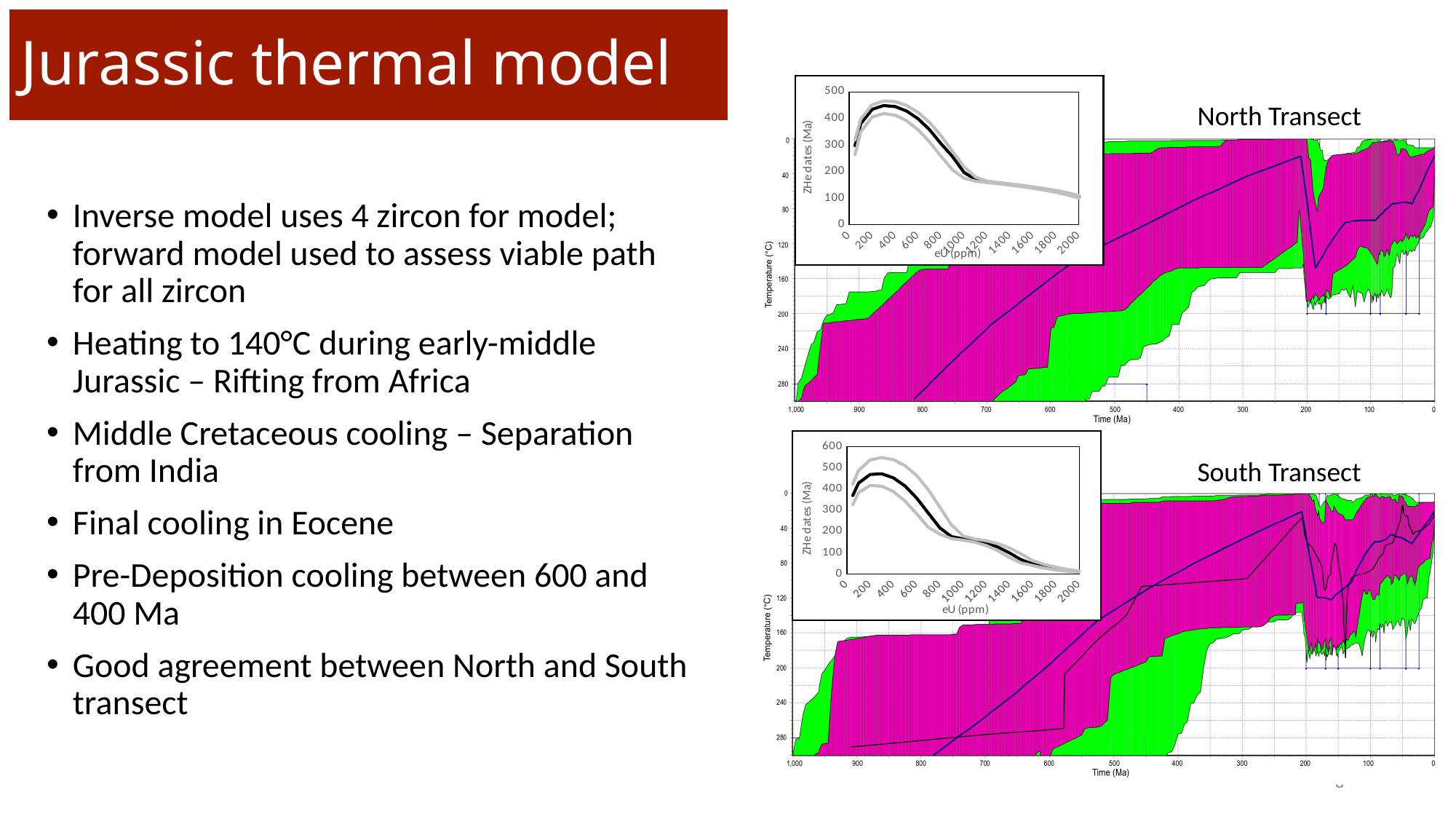
In the North Transect chart, what is the label of the x axis? Time (Ma) What kind of chart is the inset in the North Transect panel? line chart What is the highest tick value shown on the x axis of the North Transect chart? 1,000 In the inset chart of the North Transect panel, does the black line rise or fall as eU increases from 600 to 1200 ppm? fall In the inset chart of the North Transect panel, is the black line's value at eU = 2000 ppm greater or less than 200? less In the inset chart of the South Transect panel, is the peak value of the black line greater or less than 400? greater In the inset chart of the South Transect panel, is the black line's value at eU = 2000 ppm greater or less than 100? less What is the title of the lower main chart on the right side of the slide? South Transect